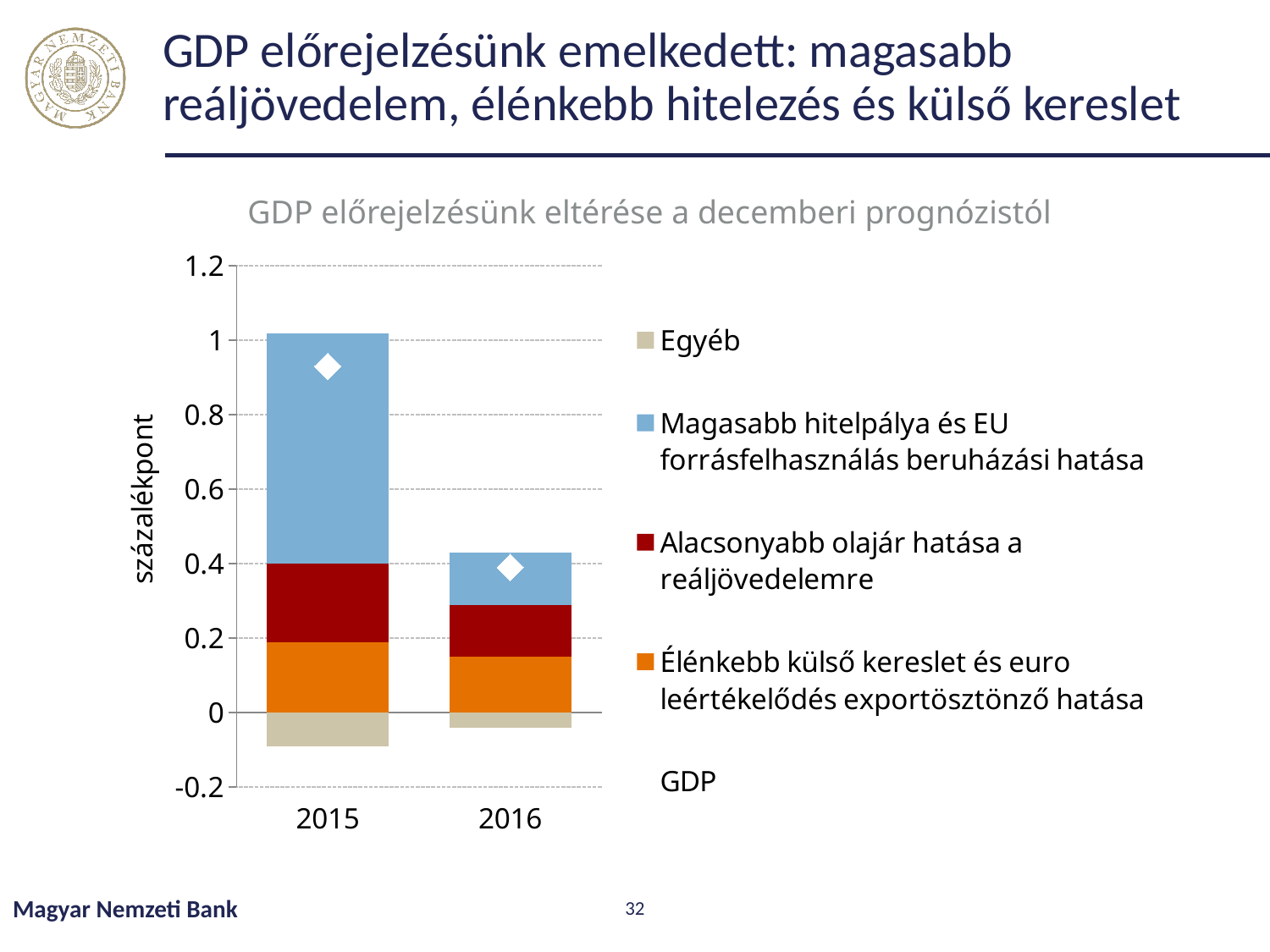
Which year has the larger 'Magasabb hitelpálya és EU forrásfelhasználás beruházási hatása' segment, 2015 or 2016? 2015 What is the label of the vertical axis? százalékpont Does the GDP value (diamond marker) rise or fall from 2015 to 2016? fall What kind of chart is shown on the slide? bar chart Is the Egyéb value for 2015 greater or less than 0? less Is the GDP value (diamond marker) for 2016 greater or less than 0.6? less How many series does the chart's legend list? 5 Is the GDP value (diamond marker) for 2015 greater or less than 0.8? greater How many categories are shown on the x axis of the chart? 2 Which year has the larger GDP value (diamond marker), 2015 or 2016? 2015 What is the title of the chart? GDP előrejelzésünk eltérése a decemberi prognózistól